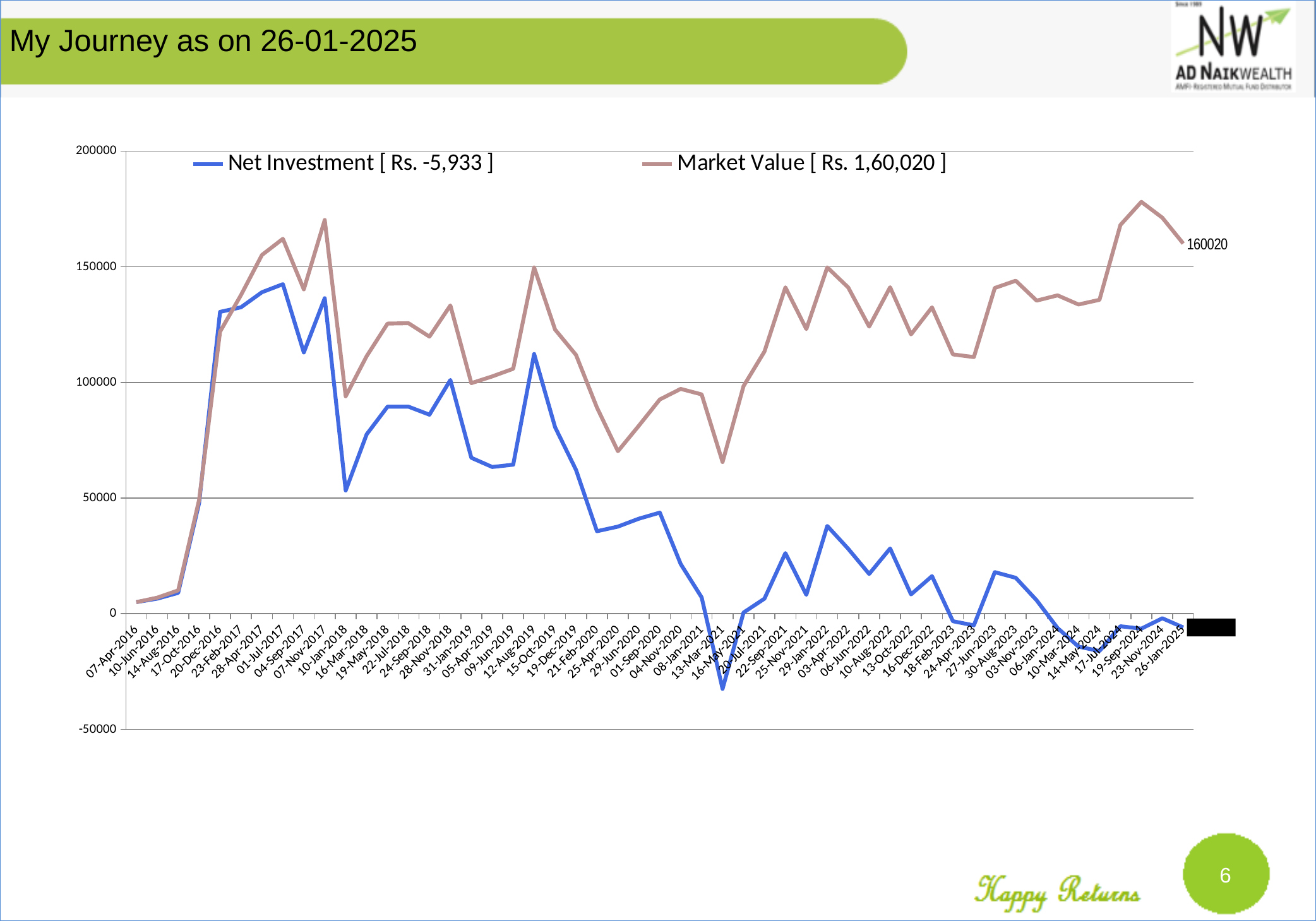
At which date does the Market Value line reach its highest point? 19-Sep-2024 At which date does the Net Investment line reach its lowest point? 13-Mar-2021 How many series does the legend list? 2 Is the Market Value on 19-Sep-2024 greater or less than 150000? greater What colour is the Net Investment line? blue What kind of chart is shown on the slide? line chart What is the Market Value on 26-Jan-2025 according to the data label? 160020 Is the Net Investment on 23-Feb-2017 greater or less than 100000? greater Is the Market Value on 07-Apr-2016 greater or less than 50000? less Does the Market Value rise or fall from 23-Nov-2024 to 26-Jan-2025? fall On 26-Jan-2025, which is larger: Net Investment or Market Value? Market Value